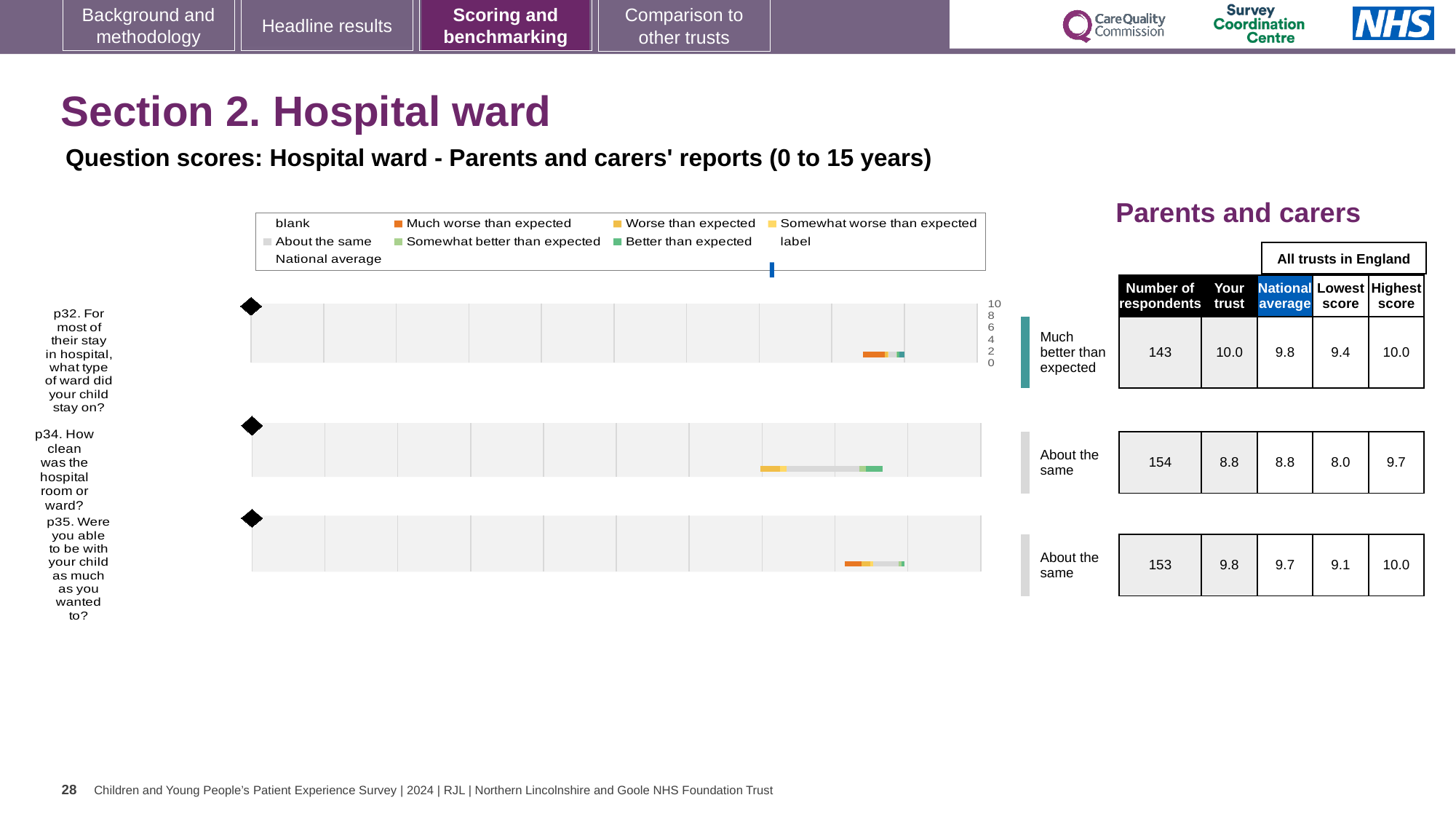
What benchmark category is shown for p34 (how clean was the hospital room or ward)? About the same What is the national average score for p35? 9.7 Which has the larger 'Your trust' score, p32 or p35? p32 How many entries does the chart legend list? 9 What colour is used for the 'Much worse than expected' legend entry? orange What benchmark category is shown for p32 (what type of ward did your child stay on)? Much better than expected What is the difference between the highest score and the lowest score for p34? 1.7 What kind of chart is shown on the slide? bar chart How many questions (categories) are plotted in the chart? 3 What is the number of respondents for p34? 154 What is the 'Your trust' score for p32? 10.0 Which question has the lowest 'Your trust' score? p34